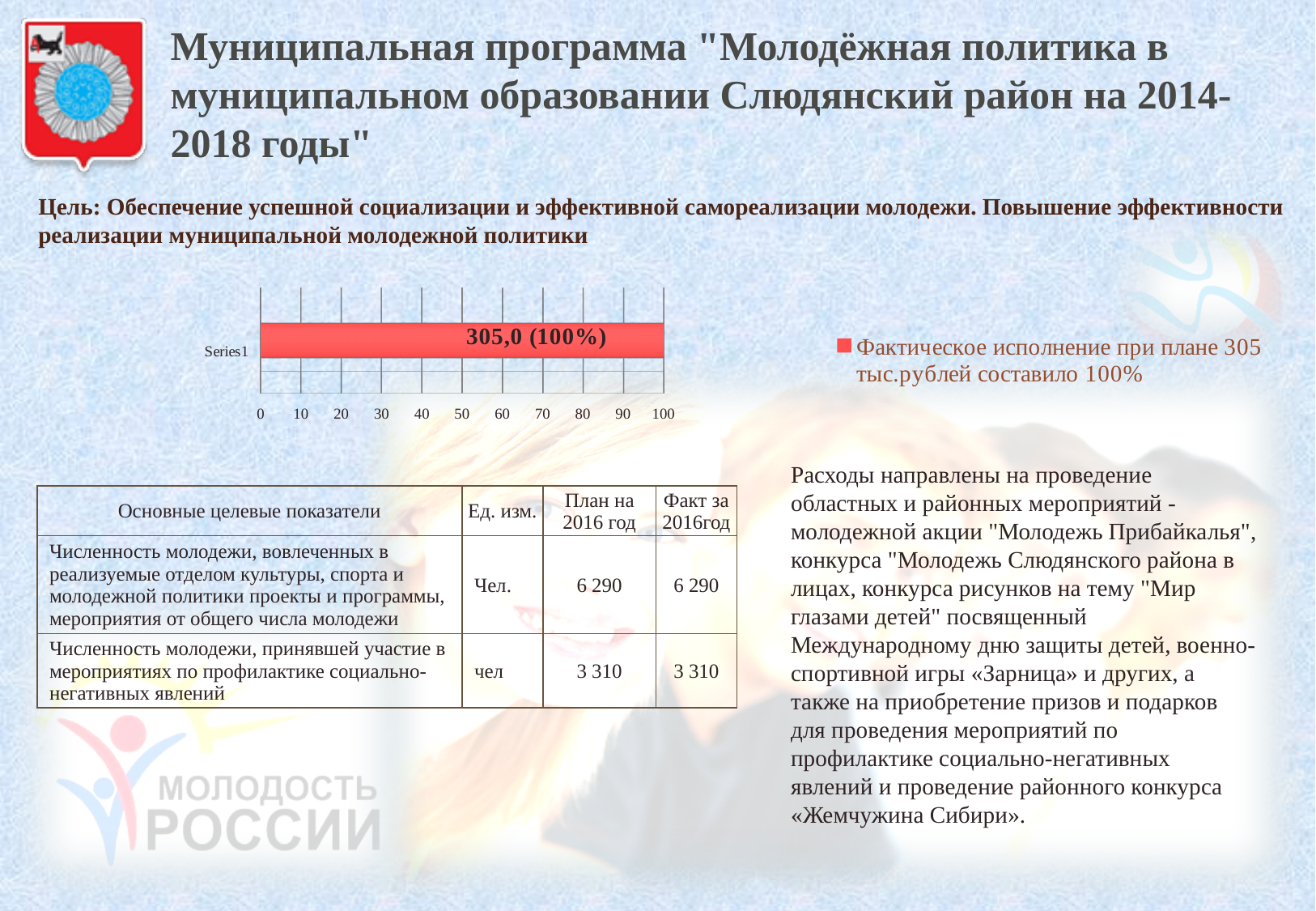
What colour is the bar in the chart? red What is the highest tick value shown on the chart's x axis? 100 How many series does the chart's legend list? 1 What kind of chart is shown on the slide? bar chart What data label is printed on the bar in the chart? 305,0 (100%) What percentage is shown in the bar's data label? 100% Is the value of the bar for Series1 greater or less than 50 on the x axis? greater What is the category label shown on the vertical axis of the chart? Series1 Is the value of the bar for Series1 greater or less than 90 on the x axis? greater How many bars does the chart contain? 1